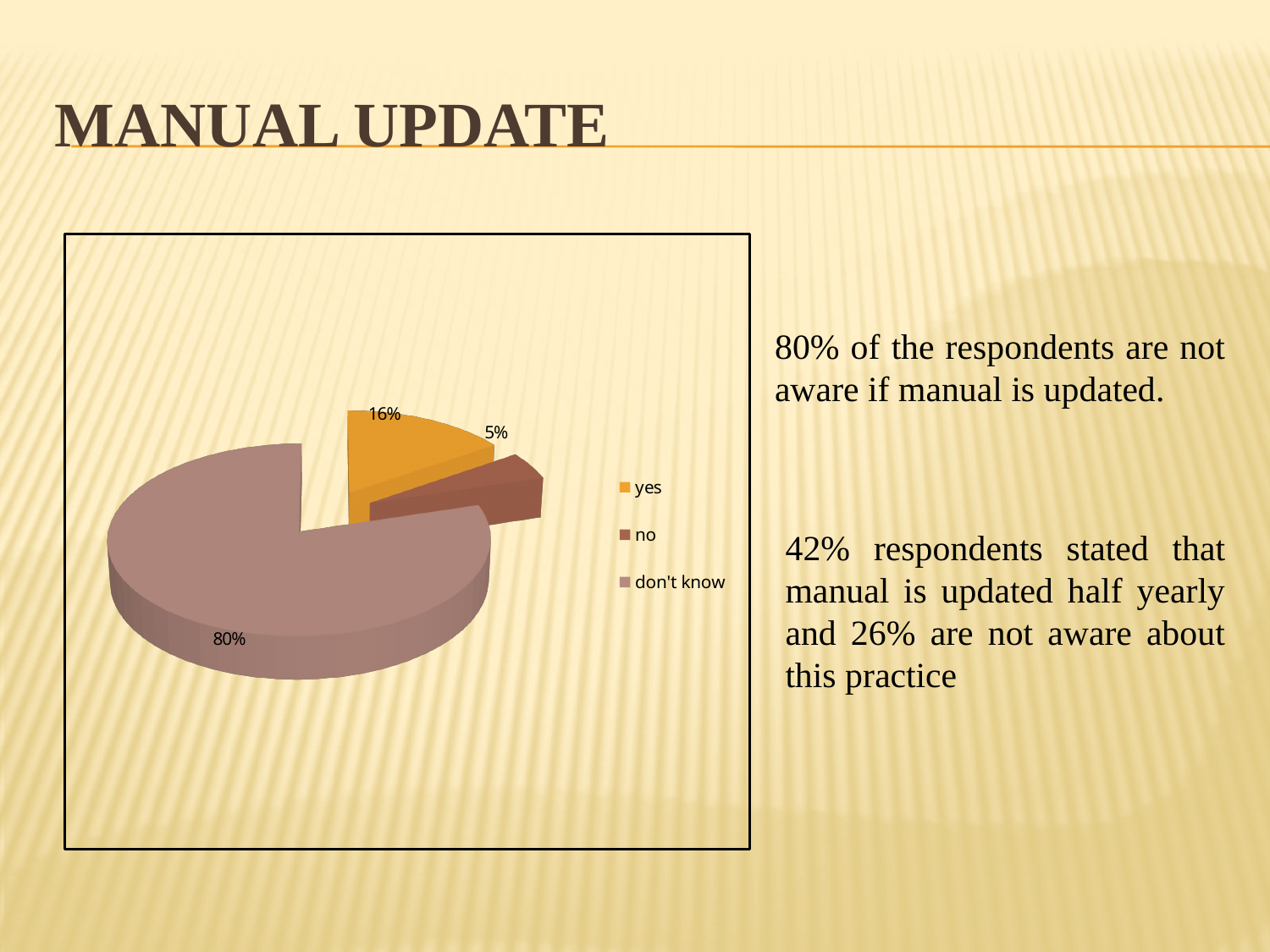
What kind of chart is shown on the slide? pie chart How many slices does the pie chart have? 3 What percentage of the pie is the 'don't know' slice? 80% Which slice is larger, 'yes' or 'no'? yes Which category has the smallest slice of the pie? no What colour is the 'yes' slice in the pie chart? orange How many entries does the legend list? 3 What is the difference in percentage points between the 'don't know' slice and the 'yes' slice? 64 What percentage of the pie is the 'yes' slice? 16% What percentage of the pie is the 'no' slice? 5% Which category has the largest slice of the pie? don't know What is the title of the slide containing the pie chart? MANUAL UPDATE